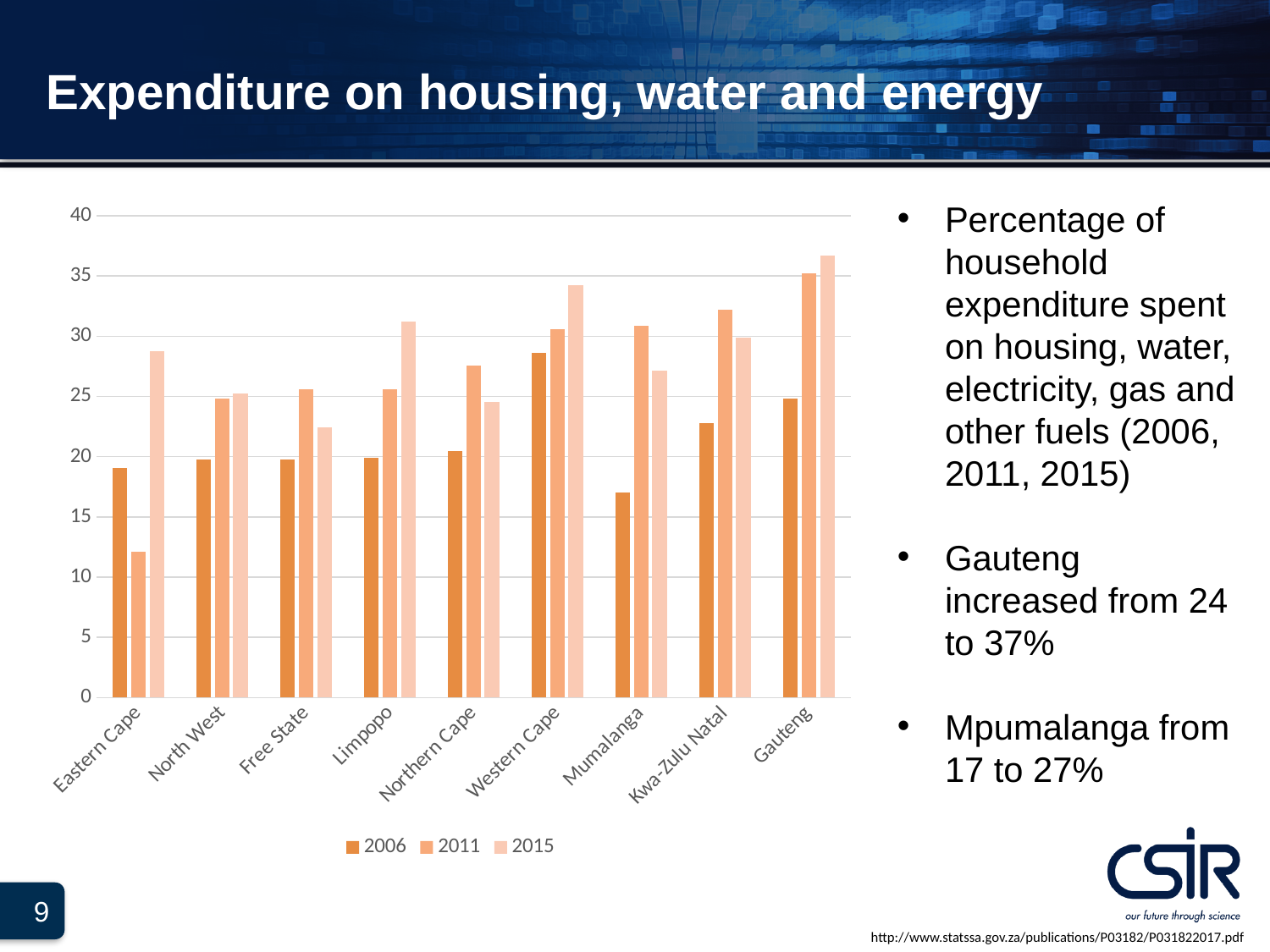
Which province has the lowest value for 2011? Eastern Cape Which province has the highest value for 2006? Western Cape Which province has the highest value for 2015? Gauteng Is the 2015 value for Gauteng greater or less than 35? greater Is the 2015 value for Limpopo greater or less than 30? greater What kind of chart is shown on the slide? Bar chart For Kwa-Zulu Natal, which is larger: the 2011 value or the 2015 value? 2011 How many series does the chart's legend list? 3 Which years are listed in the chart's legend? 2006, 2011, 2015 How many provinces (categories) are shown on the x axis of the chart? 9 Do the values for Gauteng rise or fall from 2006 to 2011 to 2015? rise Is the 2011 value for Eastern Cape greater or less than 15? less